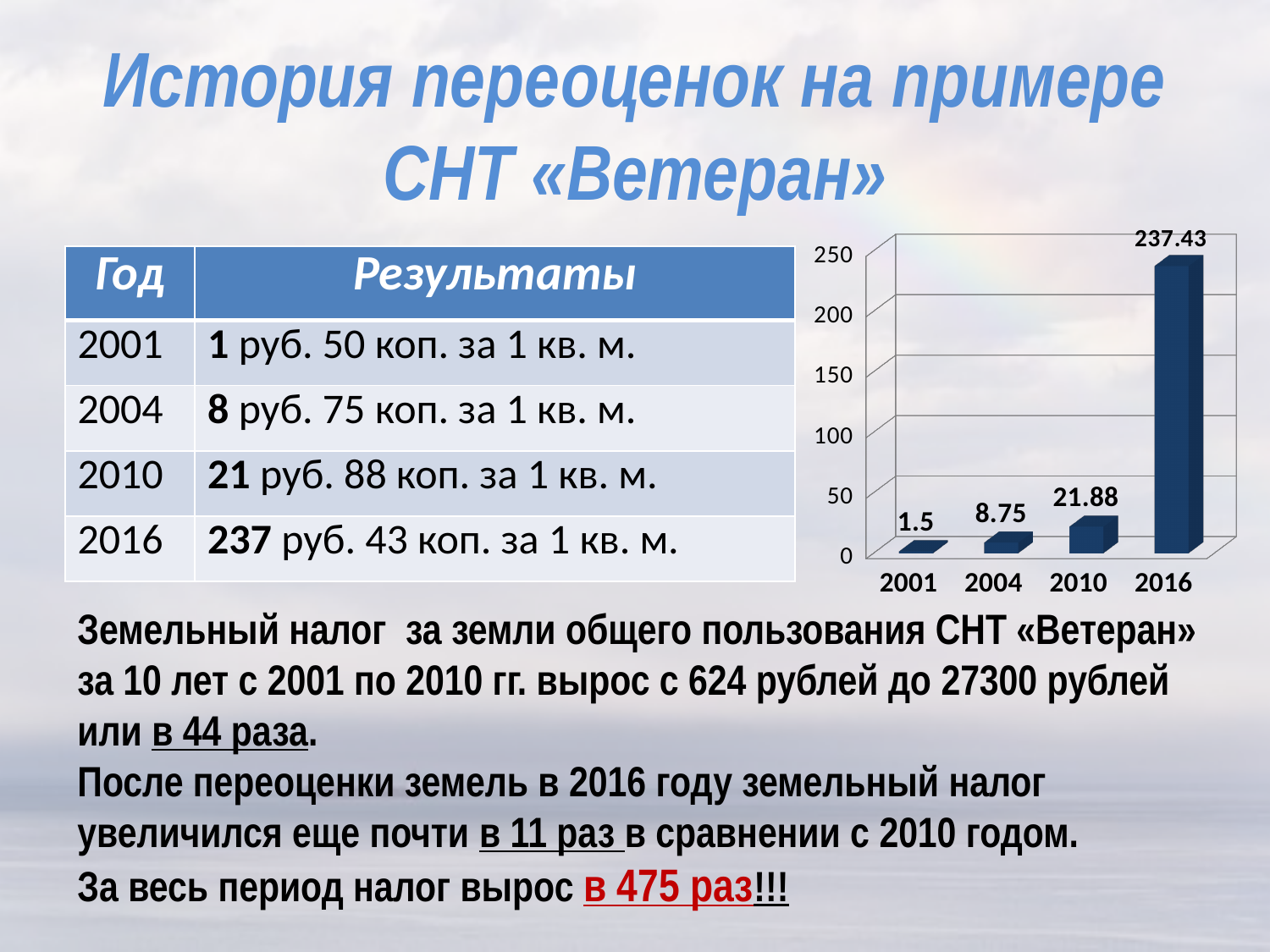
Which year has the lowest value in the chart? 2001 Is the value for 2016 greater or less than 200? greater What is the value shown for 2010 in the chart? 21.88 What is the value shown for 2016 in the chart? 237.43 Which is larger in the chart, the value for 2004 or the value for 2010? 2010 What kind of chart is shown on the slide? bar chart How many years are shown on the x axis of the chart? 4 What is the value shown for 2004 in the chart? 8.75 What is the difference between the values for 2010 and 2004 in the chart? 13.13 Which year has the highest value in the chart? 2016 What is the value shown for 2001 in the chart? 1.5 What is the difference between the values for 2016 and 2010 in the chart? 215.55